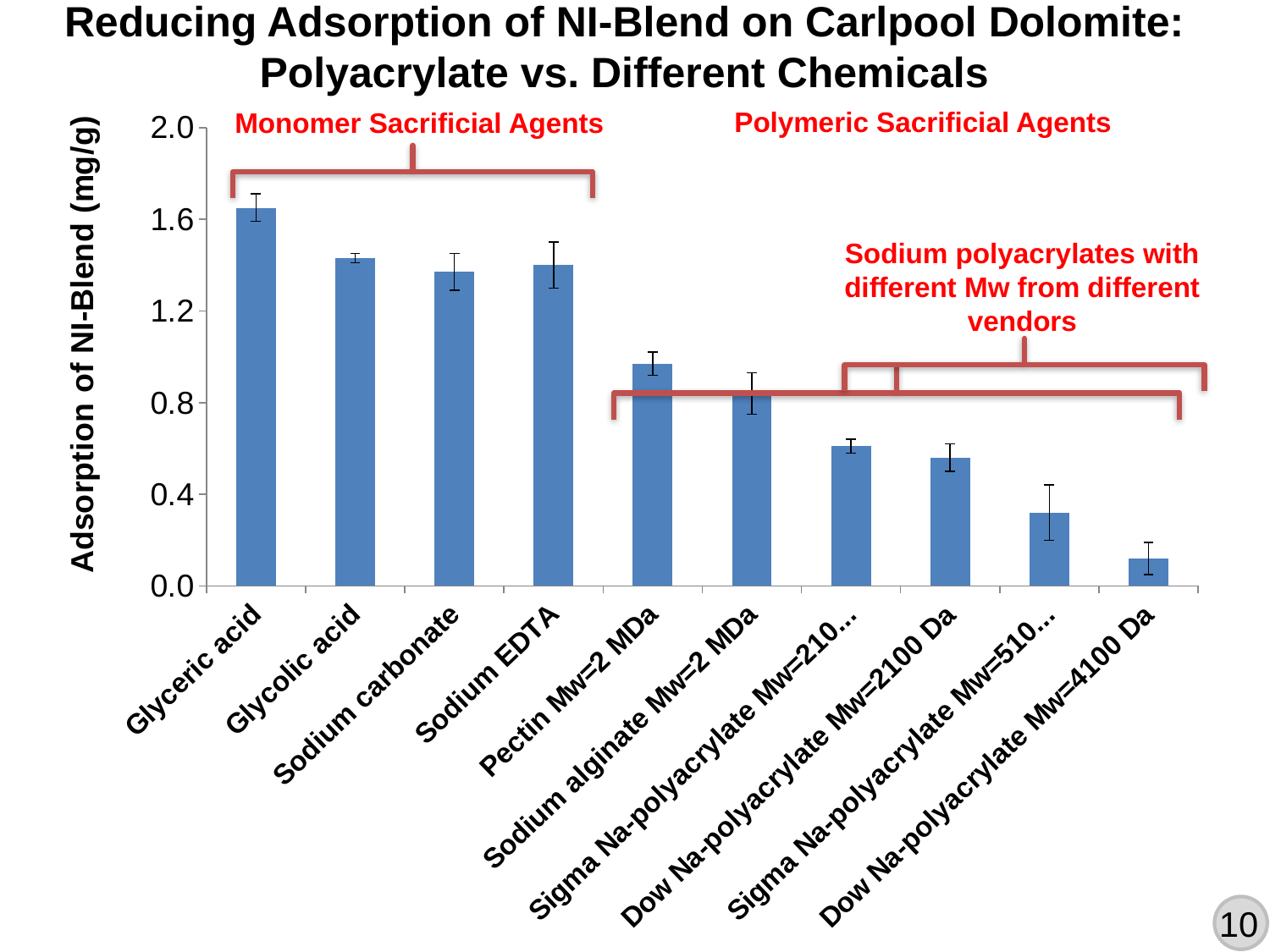
Which chemical has the highest adsorption of NI-Blend? Glyceric acid Which chemical has the lowest adsorption of NI-Blend? Dow Na-polyacrylate Mw=4100 Da Which has a higher adsorption value, Pectin Mw=2 MDa or Sodium alginate Mw=2 MDa? Pectin Mw=2 MDa Is the adsorption value for Dow Na-polyacrylate Mw=4100 Da greater or less than 0.4 mg/g? less How many chemicals (categories) are plotted on the x axis? 10 Is the adsorption value for Pectin Mw=2 MDa greater or less than 1.2 mg/g? less Is the adsorption value for Glyceric acid greater or less than 1.2 mg/g? greater Which has a higher adsorption value, Glyceric acid or Glycolic acid? Glyceric acid What is the label of the y axis? Adsorption of NI-Blend (mg/g) Do the adsorption values generally rise or fall moving from left to right along the x axis? fall What kind of chart is shown on the slide? bar chart